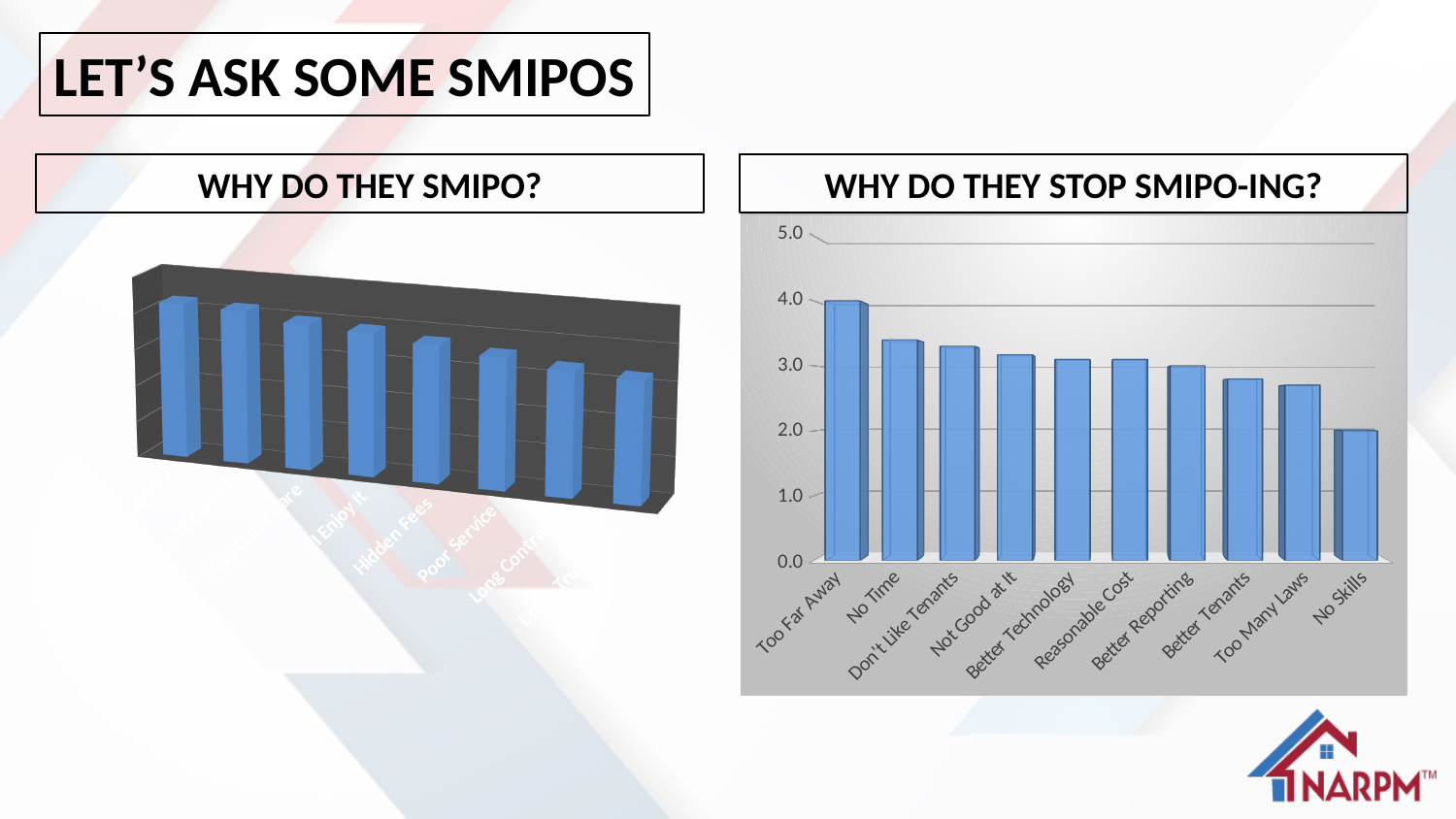
How many categories are shown on the 'WHY DO THEY STOP SMIPO-ING?' chart? 10 On the 'WHY DO THEY STOP SMIPO-ING?' chart, is the value for No Skills greater or less than 3.0? less On the 'WHY DO THEY STOP SMIPO-ING?' chart, is the value for Better Tenants greater or less than 3.0? less On the 'WHY DO THEY STOP SMIPO-ING?' chart, is the value for No Time greater or less than 3.0? greater On the 'WHY DO THEY STOP SMIPO-ING?' chart, which category has the highest value? Too Far Away On the 'WHY DO THEY STOP SMIPO-ING?' chart, do the values rise or fall from left to right? Fall On the 'WHY DO THEY STOP SMIPO-ING?' chart, which is larger, the value for No Time or the value for Too Many Laws? No Time What kind of chart is the 'WHY DO THEY STOP SMIPO-ING?' chart? Bar chart On the 'WHY DO THEY STOP SMIPO-ING?' chart, which category has the lowest value? No Skills On the 'WHY DO THEY SMIPO?' chart, do the bar values rise or fall from left to right? Fall How many bars are shown on the 'WHY DO THEY SMIPO?' chart? 8